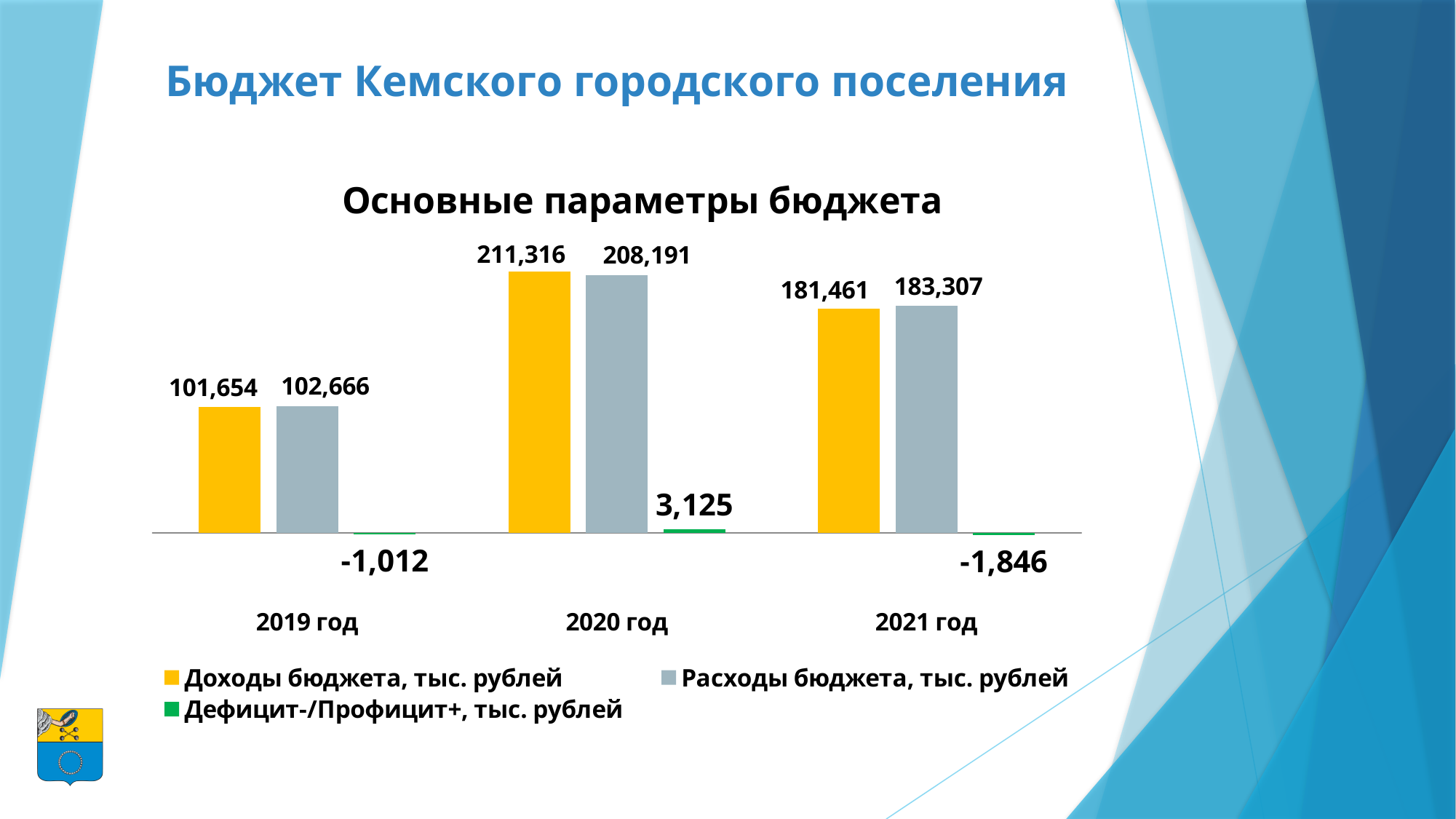
What is the value of Дефицит-/Профицит+ for 2021 год? -1,846 In 2020 год, which is larger: Доходы бюджета or Расходы бюджета? Доходы бюджета What is the difference between Расходы бюджета and Доходы бюджета in 2021 год? 1,846 Which year has the highest Доходы бюджета? 2020 год How many years are shown on the x axis? 3 Which year has the lowest Расходы бюджета? 2019 год What is the title of the chart? Основные параметры бюджета What kind of chart is shown on the slide? Bar chart What is the value of Доходы бюджета for 2020 год? 211,316 What is the value of Расходы бюджета for 2019 год? 102,666 What is the value of Дефицит-/Профицит+ for 2020 год? 3,125 How many series does the legend list? 3